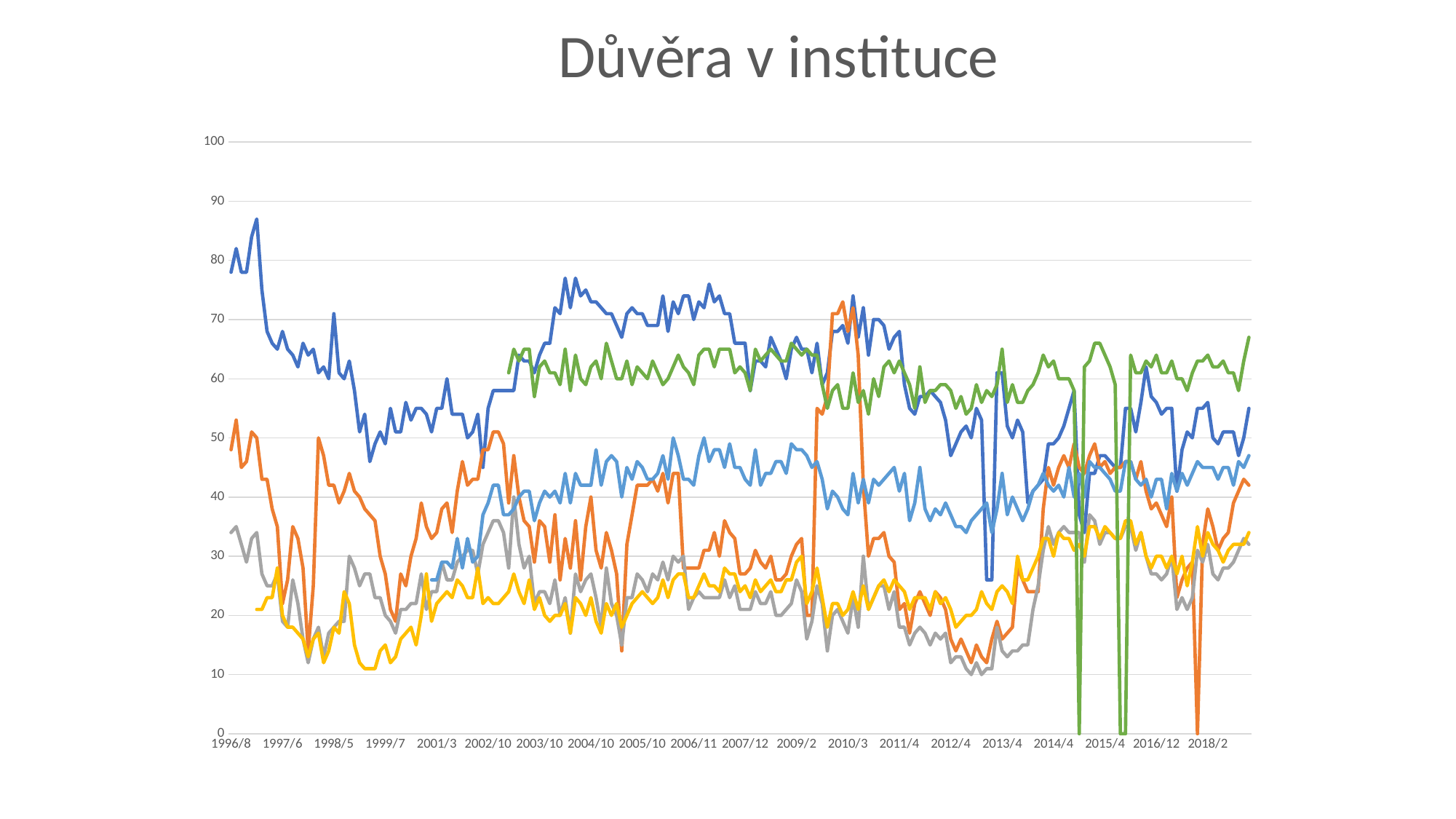
Does the dark blue line rise or fall between 1996/8 and 1998/5? fall What kind of chart is shown on the slide? line chart Is the value of the dark blue line at 1996/8 greater or less than 70? greater Is the value of the orange line at 1996/8 greater or less than 40? greater Is the value of the green line at the last point on the right greater or less than 60? greater At 1996/8, which line is higher, the dark blue line or the orange line? the dark blue line Which line reaches the highest value anywhere on the chart? the dark blue line What is the first label on the horizontal axis? 1996/8 What is the highest value shown on the vertical axis? 100 What is the title of the chart? Důvěra v instituce